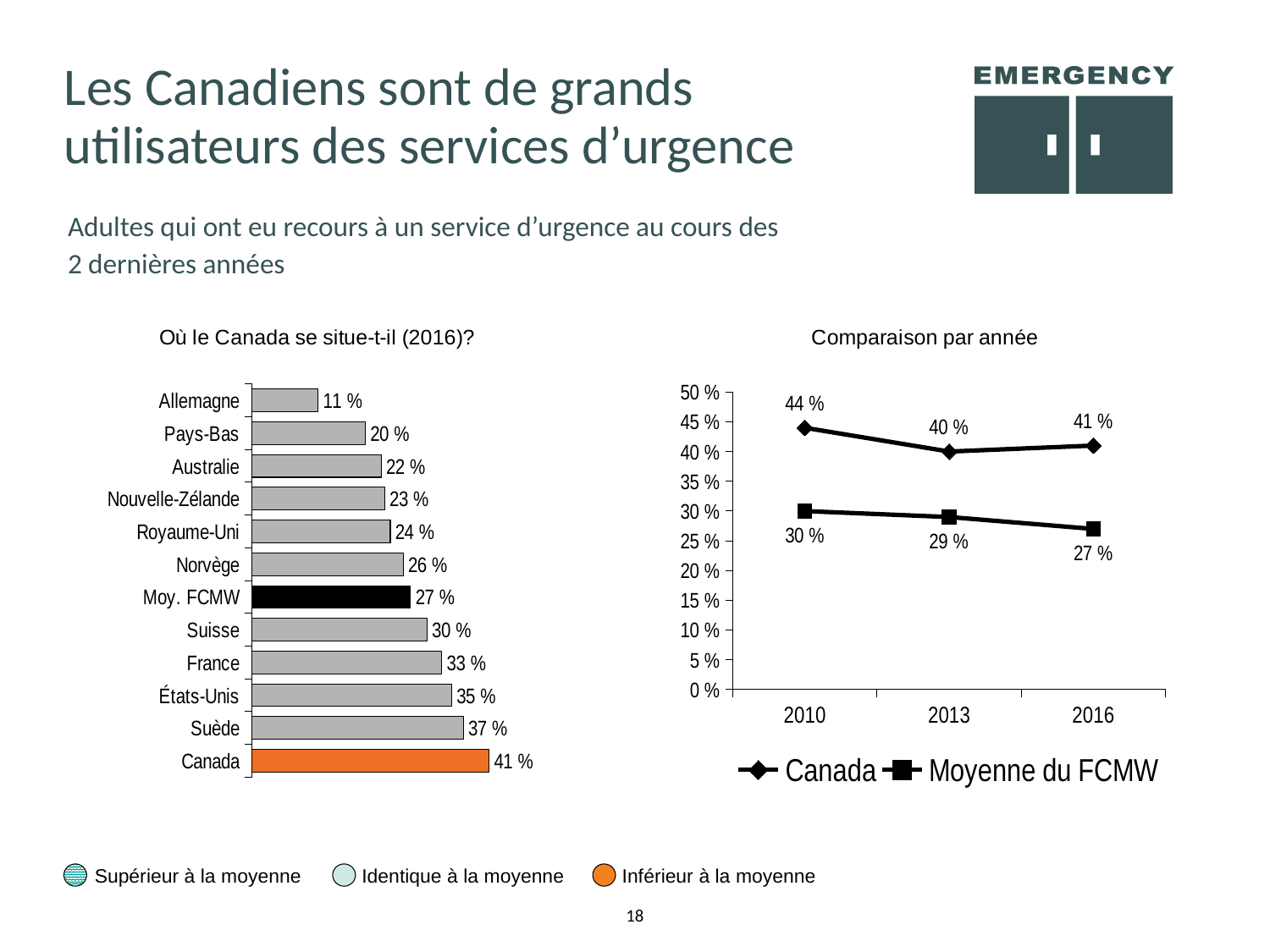
What kind of chart is 'Où le Canada se situe-t-il (2016)?'? Bar chart In the chart 'Où le Canada se situe-t-il (2016)?', which category has the highest value? Canada In the chart 'Comparaison par année', does the Moyenne du FCMW series rise or fall from 2010 to 2016? Fall In the chart 'Comparaison par année', what is the difference between Canada and Moyenne du FCMW in 2010? 14 % In the chart 'Comparaison par année', what is the value for Canada in 2013? 40 % In the chart 'Où le Canada se situe-t-il (2016)?', which country has the lowest value? Allemagne In the chart 'Où le Canada se situe-t-il (2016)?', which is larger, France or États-Unis? États-Unis How many series does the legend of the chart 'Comparaison par année' list? 2 In the chart 'Comparaison par année', what is the value for Moyenne du FCMW in 2016? 27 % In the chart 'Où le Canada se situe-t-il (2016)?', what is the value for Suède? 37 % In the chart 'Où le Canada se situe-t-il (2016)?', what is the difference between Canada and Moy. FCMW? 14 % In the chart 'Où le Canada se situe-t-il (2016)?', how many categories are shown? 12